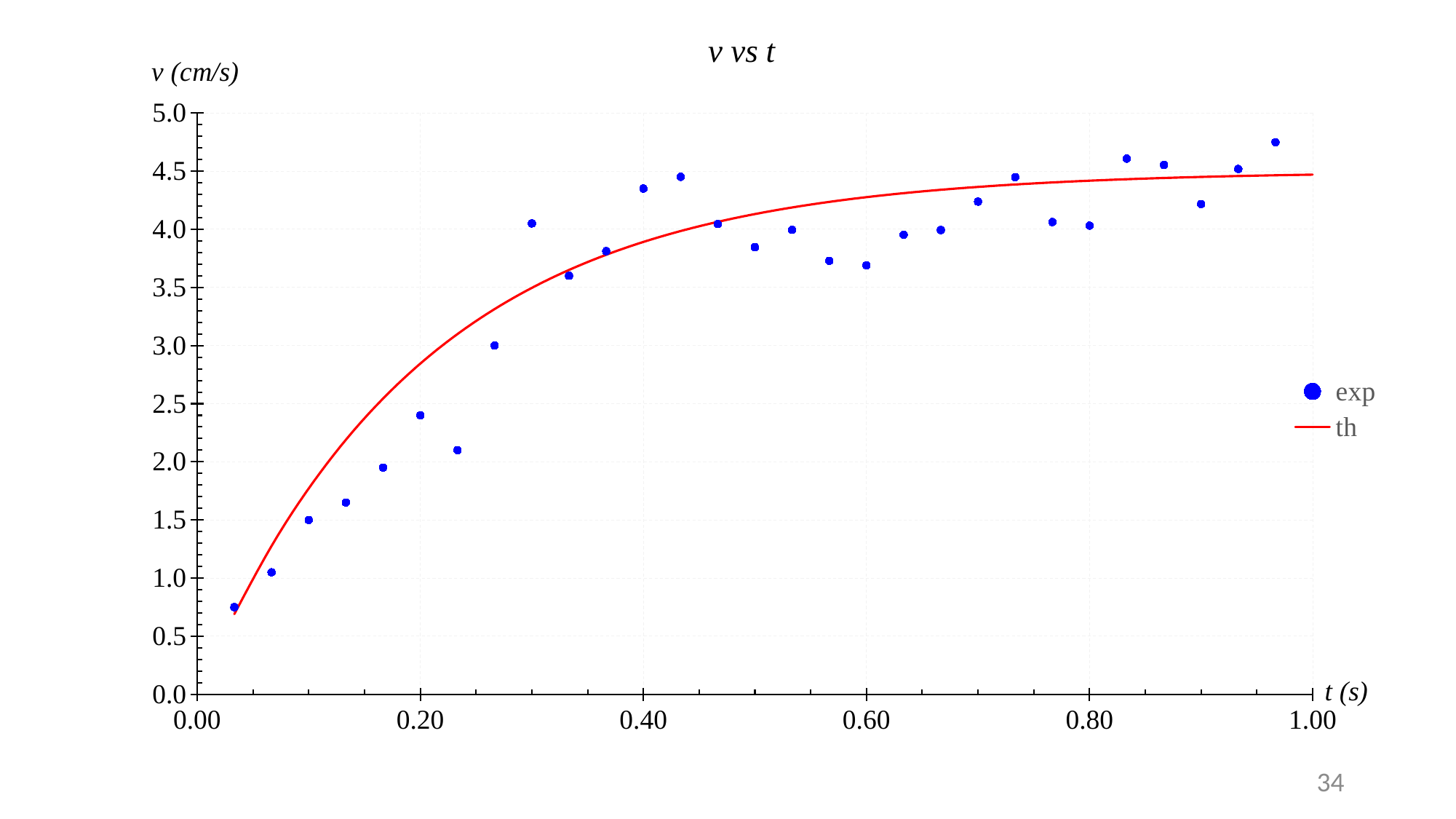
Is the exp value at t = 0.20 s greater or less than 3.0? less How many exp data points are plotted? 29 Do the exp values generally rise or fall as t increases? Rise What is the title of the chart? v vs t Is the exp value at t = 0.80 s greater or less than 3.5? greater What kind of chart is shown on the slide? Scatter plot with a fitted line Is the exp value at t = 0.40 s greater or less than 4.0? greater What are the names of the two series in the legend? exp and th At t = 0.20 s, which is higher, the exp point or the th curve? th Which is larger, the exp value at t = 0.20 s or at t = 0.40 s? t = 0.40 s How many series does the legend list? 2